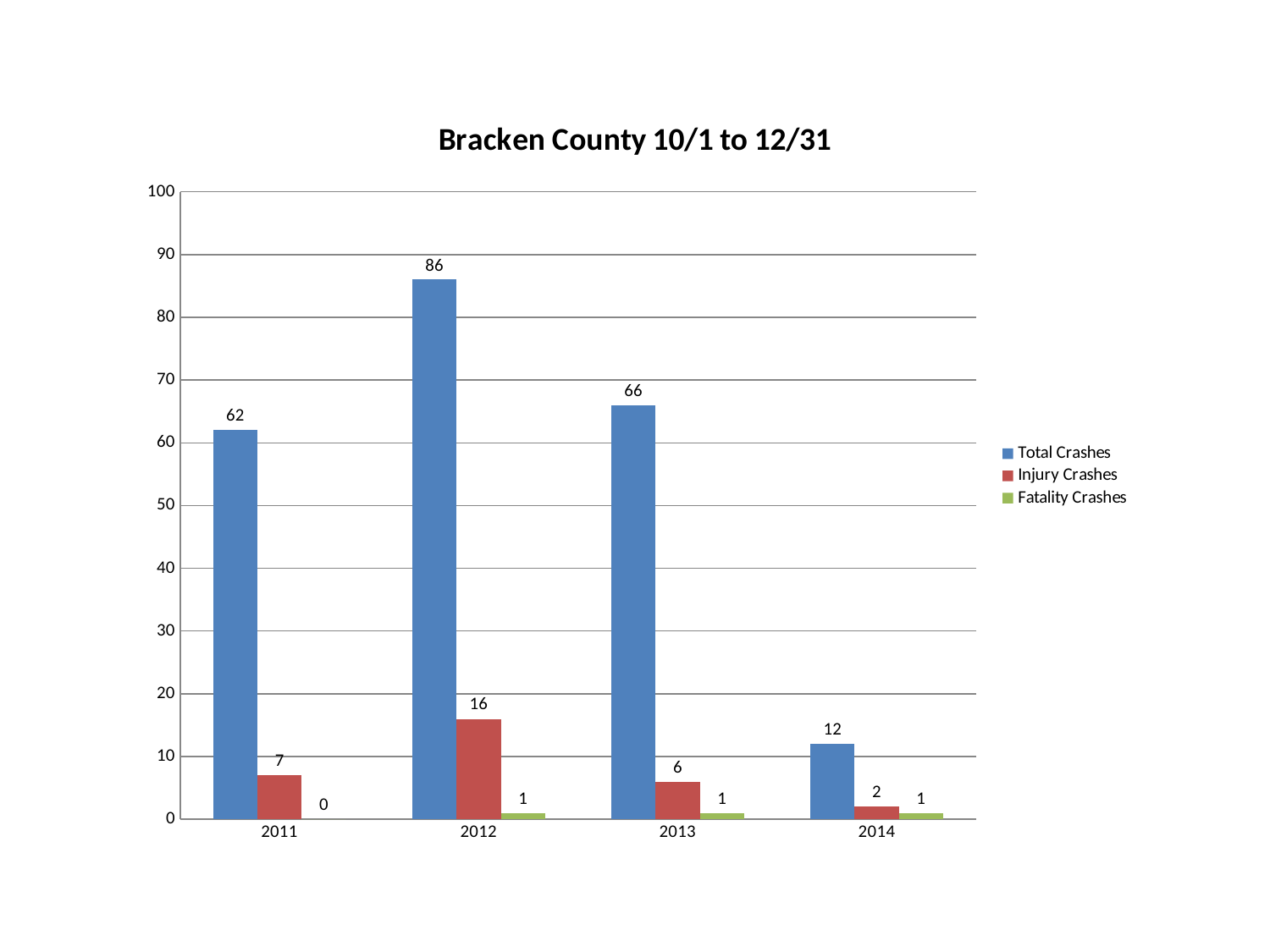
Which year has the lowest Injury Crashes? 2014 How many series does the legend list? 3 What is the value for Injury Crashes in 2011? 7 What is the difference between Total Crashes in 2012 and 2013? 20 Which year has the highest Total Crashes? 2012 Is the value for Total Crashes in 2011 greater or less than 50? greater What is the value for Fatality Crashes in 2014? 1 What kind of chart is this? bar chart What is the value for Total Crashes in 2012? 86 Which is larger, Injury Crashes in 2012 or Injury Crashes in 2013? Injury Crashes in 2012 What is the title of the chart? Bracken County 10/1 to 12/31 How many years are shown on the x axis? 4